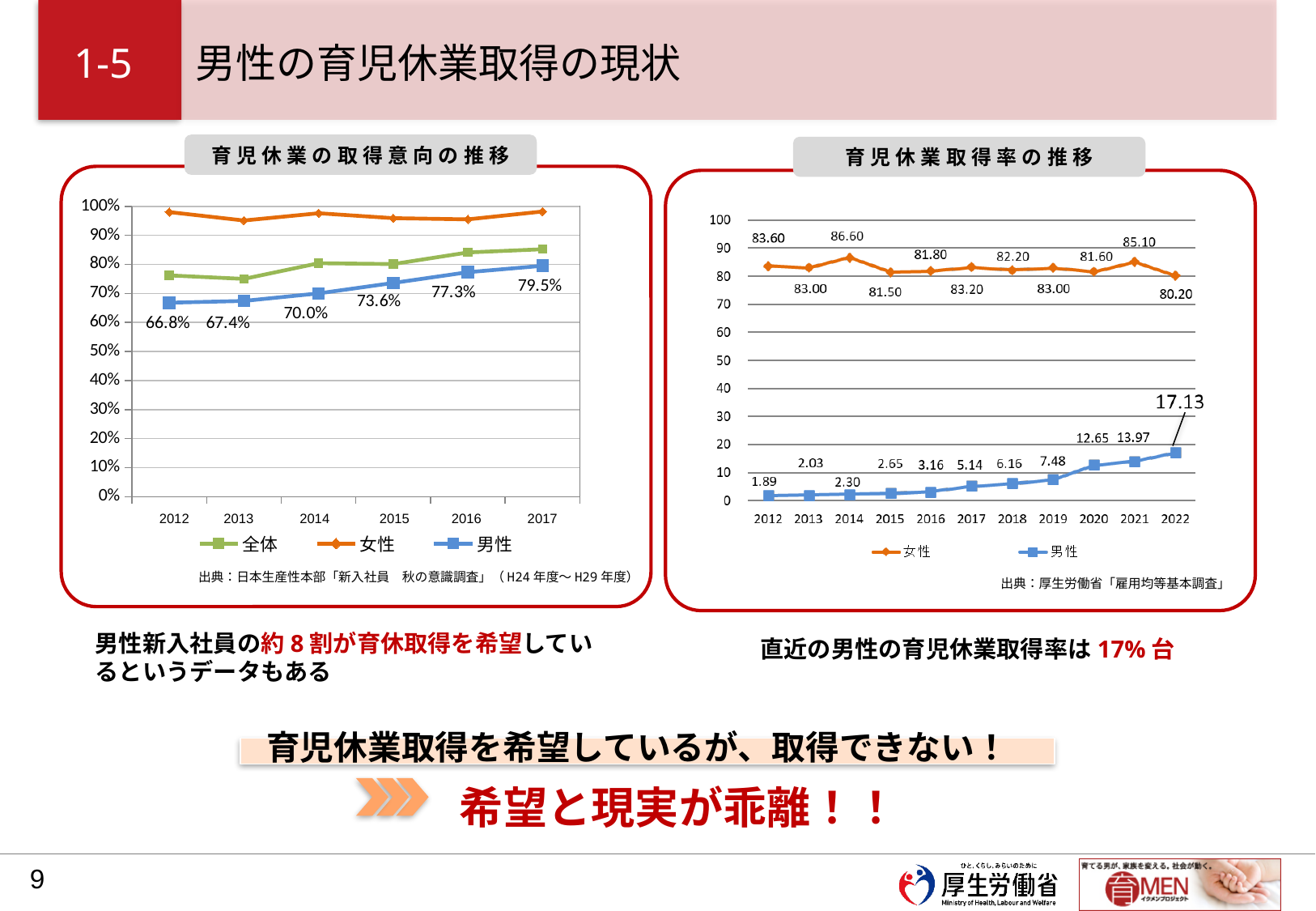
In the chart titled 育児休業取得率の推移, what is the value for 女性 in 2014? 86.60 In the chart titled 育児休業取得率の推移, in which year is the 女性 value lowest? 2022 In the chart titled 育児休業の取得意向の推移, does the 男性 series rise or fall from 2012 to 2017? rise In the chart titled 育児休業取得率の推移, what is the value for 男性 in 2022? 17.13 In the chart titled 育児休業の取得意向の推移, what is the value for 男性 in 2012? 66.8% In the chart titled 育児休業取得率の推移, how many years are shown on the x axis? 11 In the chart titled 育児休業の取得意向の推移, by how much did the 男性 value increase from 2012 to 2017? 12.7 percentage points In the chart titled 育児休業の取得意向の推移, what is the value for 男性 in 2017? 79.5% In the chart titled 育児休業取得率の推移, what is the difference between the 女性 and 男性 values in 2022? 63.07 What kind of chart is the chart titled 育児休業取得率の推移? line chart In the chart titled 育児休業の取得意向の推移, is the 女性 value in 2014 greater or less than 90%? greater In the chart titled 育児休業の取得意向の推移, how many series does the legend list? 3